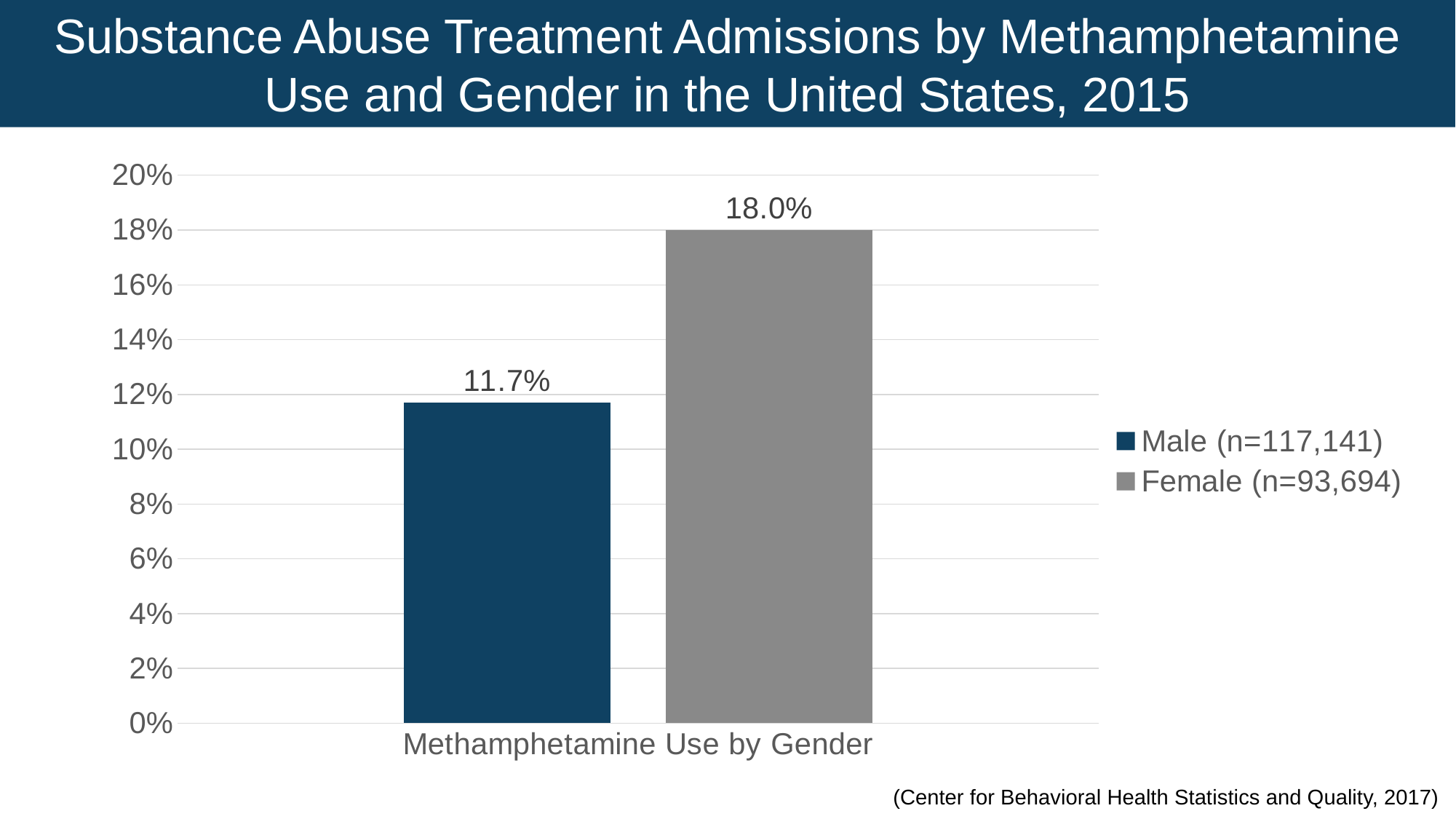
What is the label on the x axis of the chart? Methamphetamine Use by Gender Is the value for Male greater or less than 10%? greater What is the value for Female (n=93,694)? 18.0% How many series does the legend list? 2 Is the value for Female greater or less than 20%? less What is the difference between the Female value and the Male value? 6.3% Which series has the lower value, Male or Female? Male Is the value for Male greater or less than the value for Female? less What is the value for Male (n=117,141)? 11.7% Which series has the higher value, Male or Female? Female What kind of chart is shown on the slide? bar chart What colour is the bar for Female (n=93,694)? grey